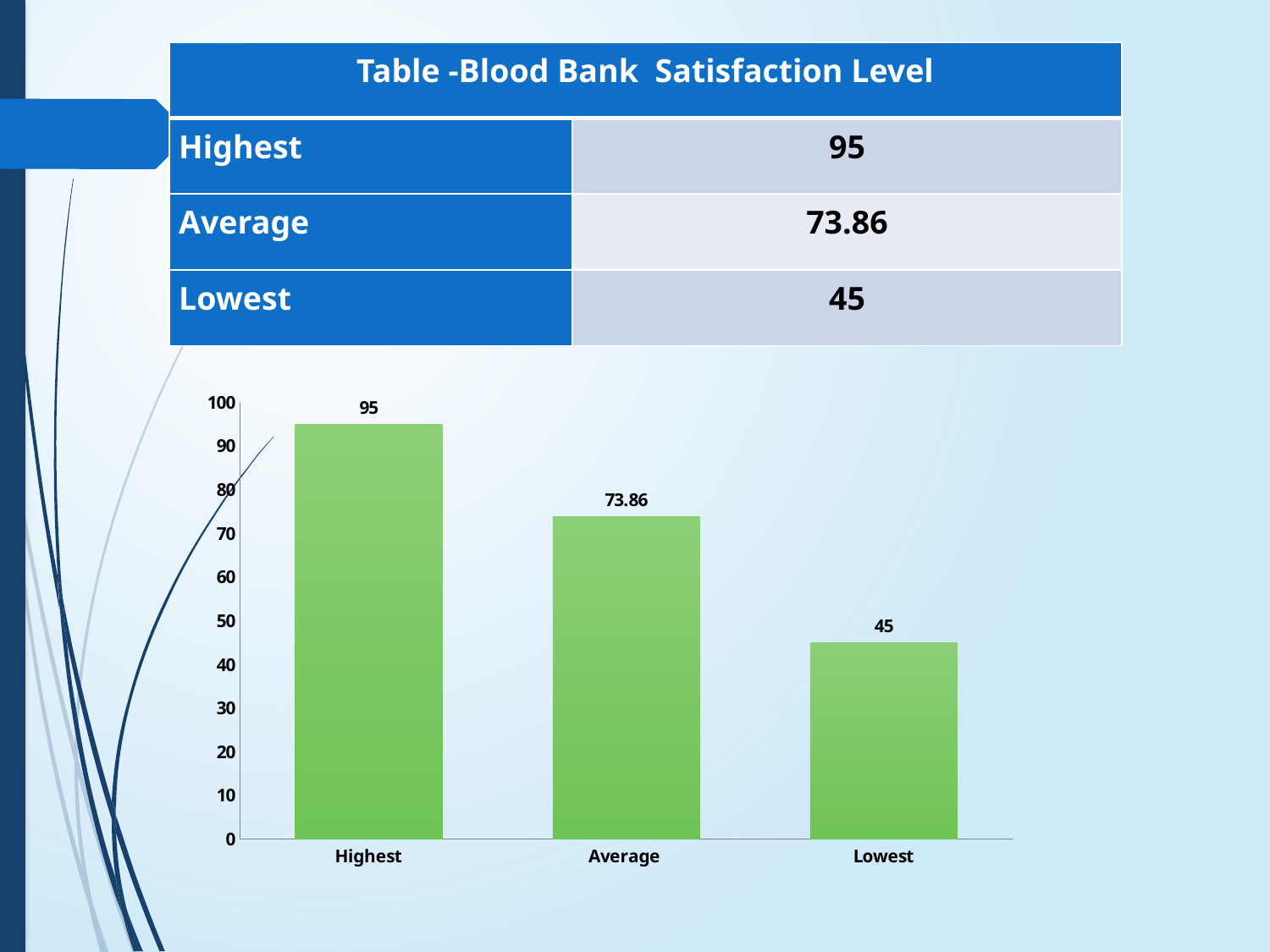
Do the bar values rise or fall from left to right across the chart? fall Which is larger in the chart, the Average bar or the Lowest bar? Average Which category has the tallest bar in the chart? Highest What is the value of the Highest bar in the chart? 95 How many bars are shown in the chart? 3 Which category has the shortest bar in the chart? Lowest What is the difference between the Highest and Average bars in the chart? 21.14 What is the value of the Average bar in the chart? 73.86 What is the difference between the Highest and Lowest bars in the chart? 50 What kind of chart is shown on the slide? bar chart What is the value of the Lowest bar in the chart? 45 Is the value for Average in the chart greater or less than 70? greater